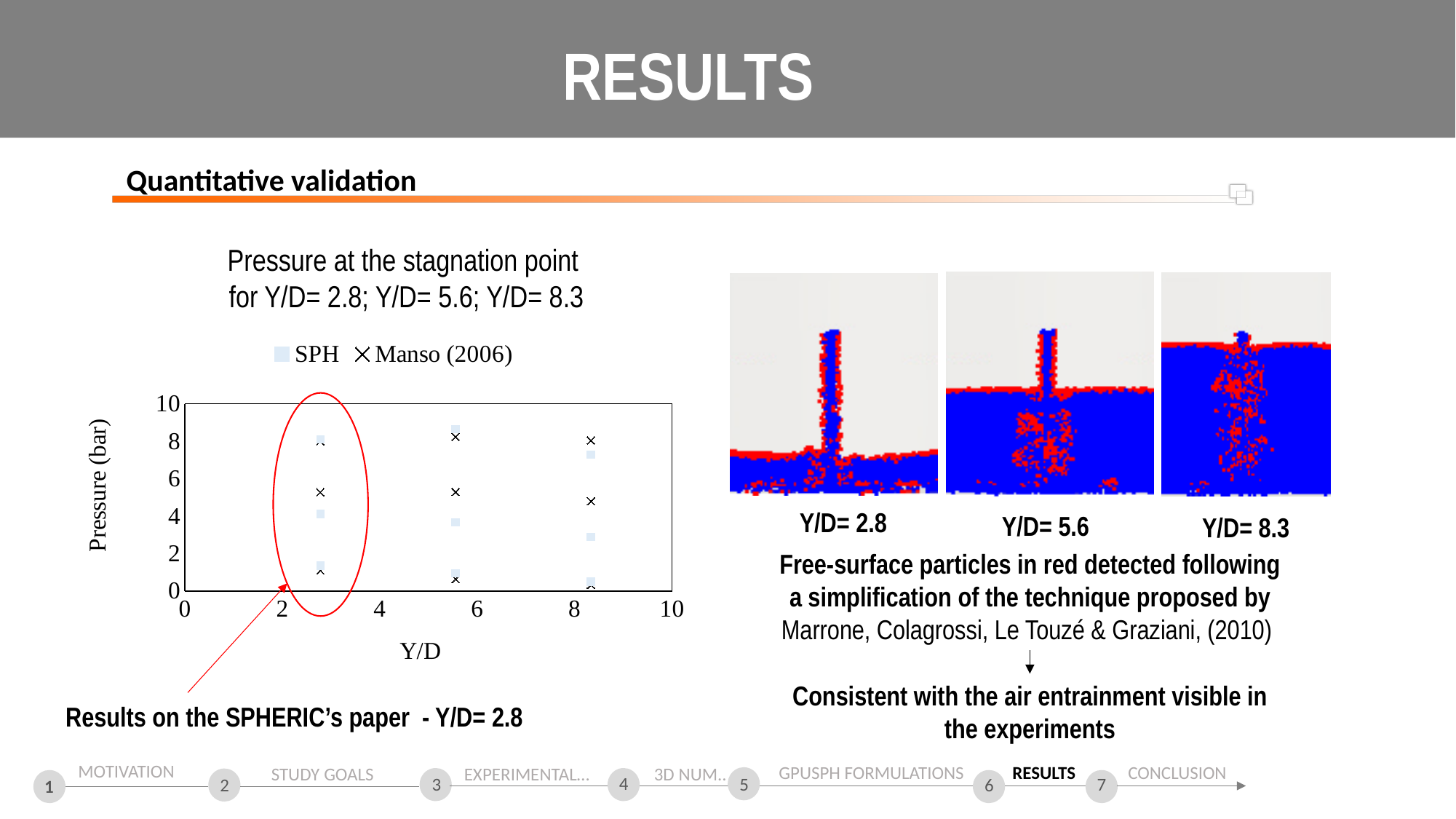
What is the label of the vertical axis of the chart? Pressure (bar) Is the middle SPH pressure value at Y/D= 5.6 greater or less than 2 bar? greater Is the middle Manso (2006) pressure value at Y/D= 8.3 greater or less than 4 bar? greater At how many Y/D positions are data points plotted in the chart? 3 Is the lowest SPH pressure value at Y/D= 2.8 greater or less than 2 bar? less What are the two series named in the chart legend? SPH and Manso (2006) How many series does the chart legend list? 2 What kind of chart is shown on the slide? scatter chart What is the maximum value shown on the Pressure (bar) axis of the chart? 10